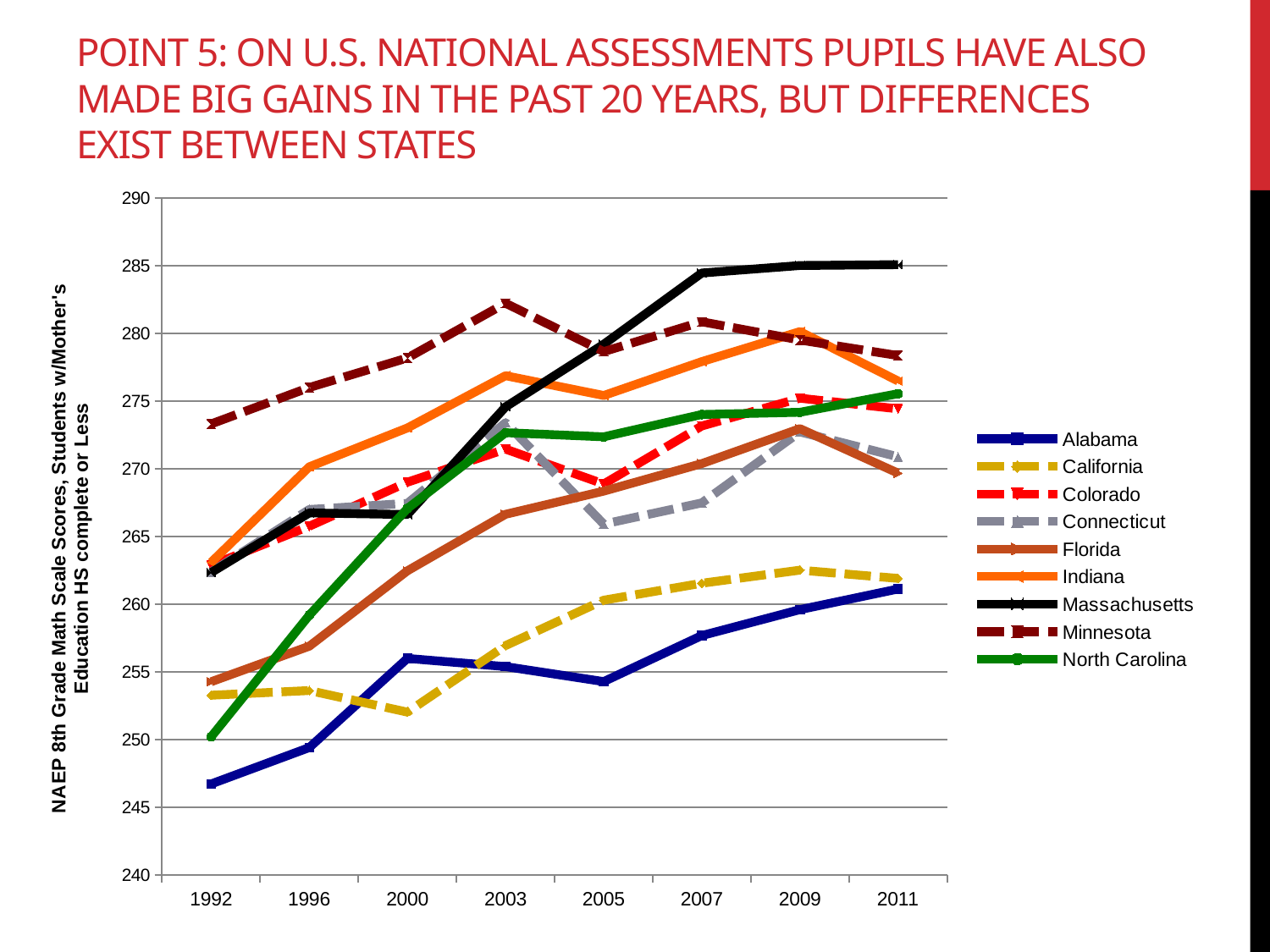
Which state had the lowest score in 1992? Alabama Which state had the lowest score in 2005? Alabama How many years are shown along the x axis? 8 Is the value for Alabama in 1992 greater or less than 250? less What is the label on the y axis? NAEP 8th Grade Math Scale Scores, Students w/Mother's Education HS complete or Less How many states (series) does the legend list? 9 What kind of chart is shown on the slide? line chart In 2011, which is higher: Massachusetts or Minnesota? Massachusetts Which state had the highest score in 2011? Massachusetts Which state had the highest score in 1992? Minnesota Is the value for Massachusetts in 2011 greater or less than 280? greater Does the Alabama line generally rise or fall from 1992 to 2011? rise